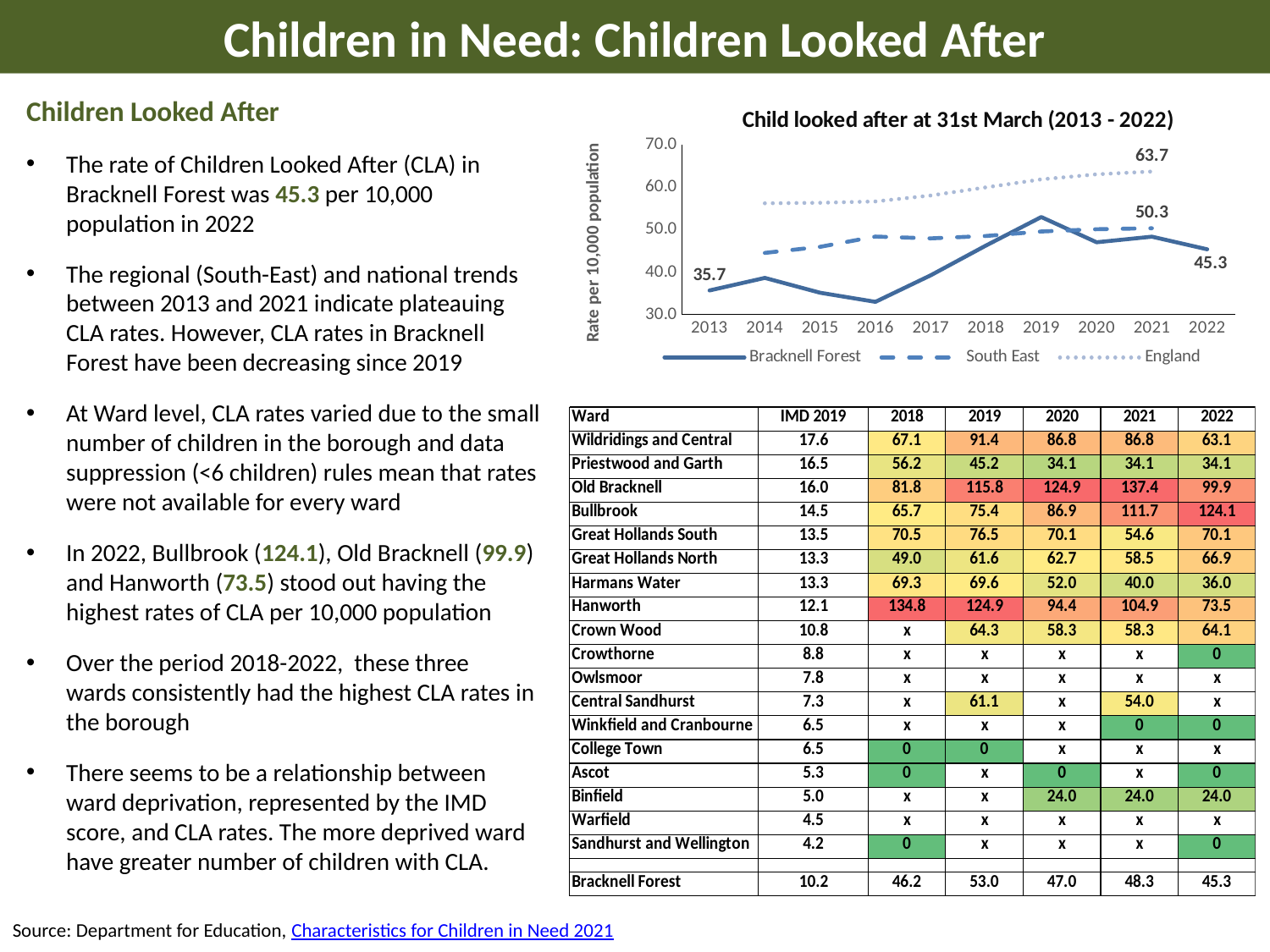
Does the Bracknell Forest line rise or fall between 2019 and 2022? fall By how much did the Bracknell Forest rate change between 2013 and 2022? 9.6 What kind of chart is shown on the slide? line chart Is the Bracknell Forest value for 2016 greater or less than 40.0? less What was the Bracknell Forest rate per 10,000 population in 2022? 45.3 How many series does the legend list? 3 What was the Bracknell Forest rate per 10,000 population in 2013? 35.7